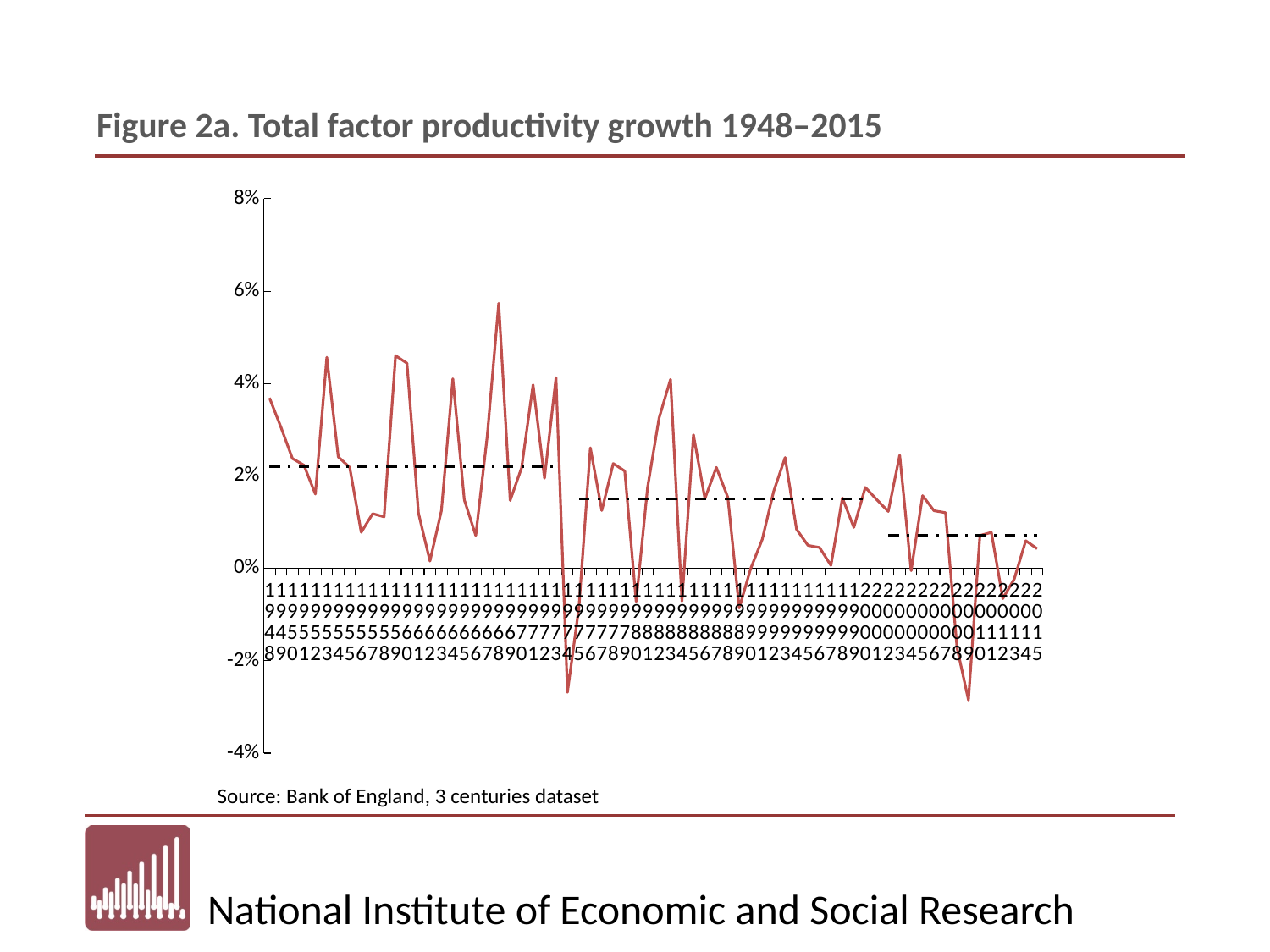
Is the value for 2015 greater or less than 2%? less Over the whole period from 1948 to 2015, do the values on the chart generally rise or fall? fall How many years (data points) does the chart cover? 68 What kind of chart is shown on the slide? line chart Which is larger, the value for 1948 or the value for 2015? 1948 What is the title of the chart? Figure 2a. Total factor productivity growth 1948–2015 Is the highest value on the chart greater or less than 4%? greater Is the value for 2009 greater or less than -2%? less What is the highest value shown on the vertical axis? 8%